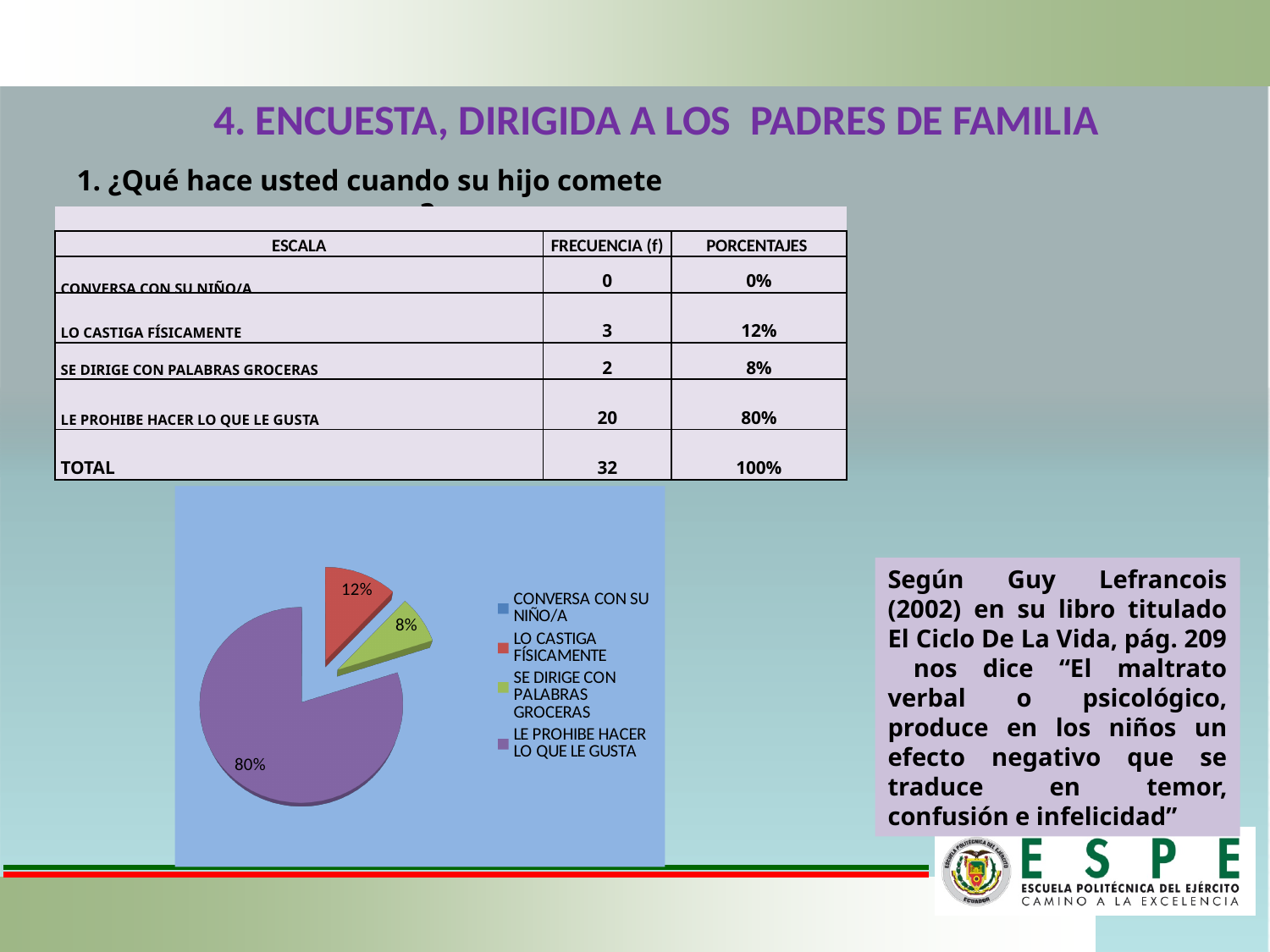
What colour is the largest slice of the pie chart? purple What percentage does the pie chart show for LE PROHIBE HACER LO QUE LE GUSTA? 80% What share of the pie does the SE DIRIGE CON PALABRAS GROCERAS slice represent? 8% What is the difference between the LE PROHIBE HACER LO QUE LE GUSTA slice and the LO CASTIGA FÍSICAMENTE slice? 68% Which category has the largest slice in the pie chart? LE PROHIBE HACER LO QUE LE GUSTA What percentage does the pie chart show for SE DIRIGE CON PALABRAS GROCERAS? 8% What percentage does the pie chart show for LO CASTIGA FÍSICAMENTE? 12% Which is larger in the pie chart: LO CASTIGA FÍSICAMENTE or SE DIRIGE CON PALABRAS GROCERAS? LO CASTIGA FÍSICAMENTE What is the difference between the LO CASTIGA FÍSICAMENTE slice and the SE DIRIGE CON PALABRAS GROCERAS slice? 4% How many entries does the pie chart's legend list? 4 Which legend entry corresponds to the red slice of the pie chart? LO CASTIGA FÍSICAMENTE What kind of chart is shown on the slide? pie chart